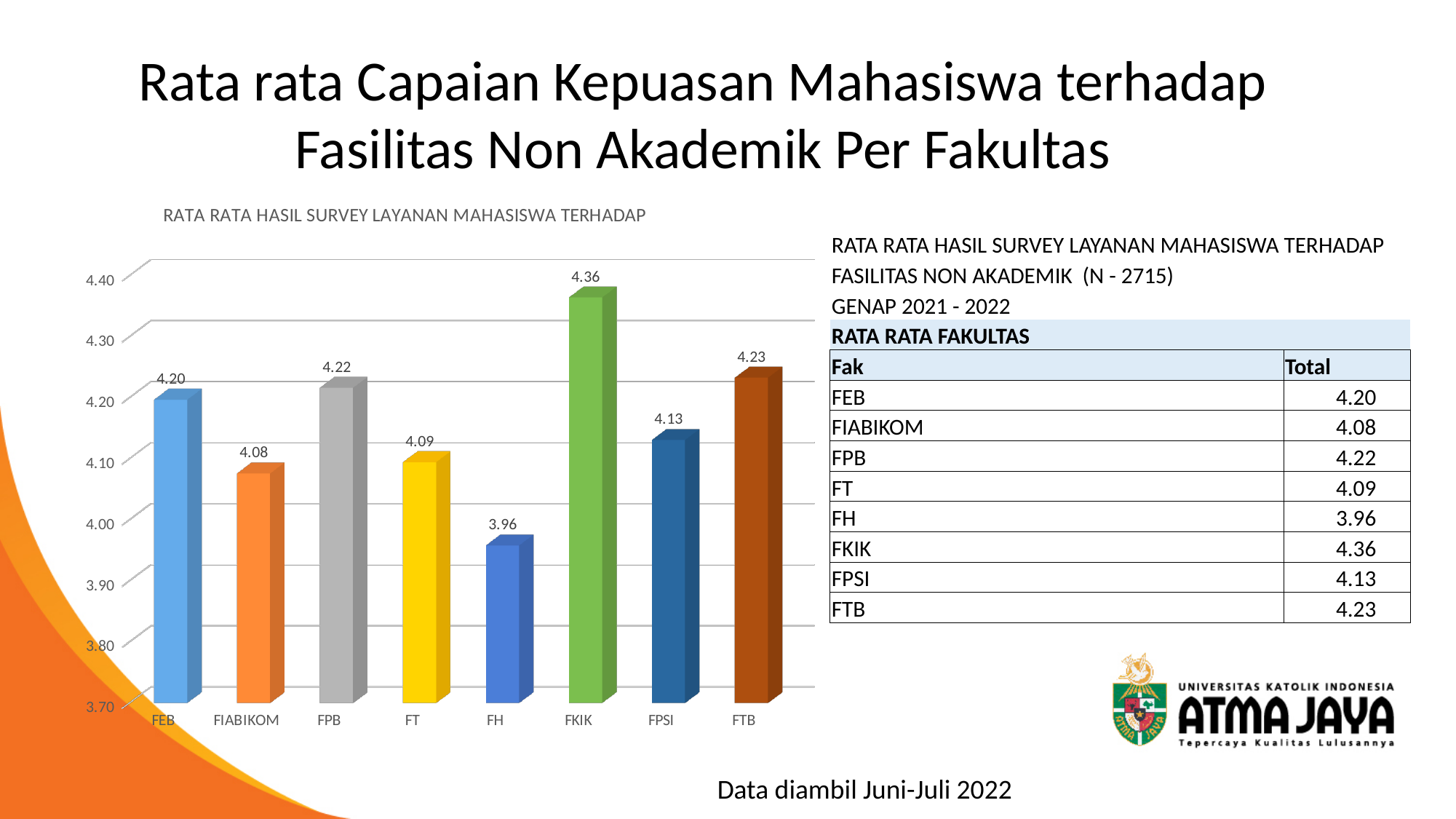
What is the value for FKIK in the chart? 4.36 Which faculty has the lowest value in the chart? FH What is the difference between the values for FKIK and FH? 0.40 Is the value for FPSI greater or less than 4.10? greater Which is larger, the value for FEB or the value for FT? FEB What is the title of the chart? RATA RATA HASIL SURVEY LAYANAN MAHASISWA TERHADAP How many faculties are shown in the chart? 8 Which faculty has the highest value in the chart? FKIK What is the difference between the values for FTB and FPB? 0.01 What kind of chart is shown on the slide? bar chart What is the value for FH in the chart? 3.96 What is the value for FIABIKOM in the chart? 4.08